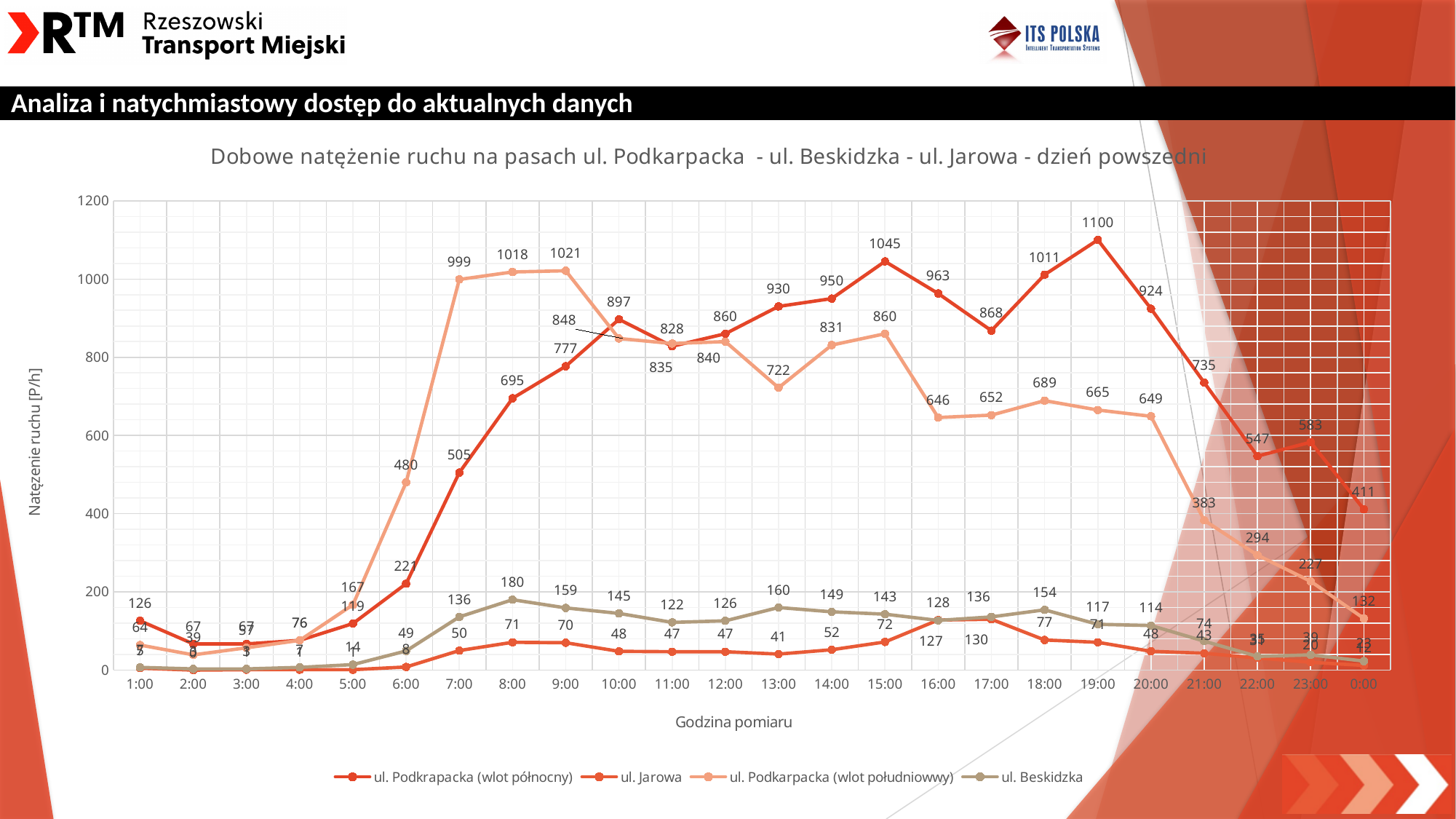
What is the highest value reached by ul. Podkarpacka (wlot południowwy)? 1021 What is the label of the x axis? Godzina pomiaru At which hour does ul. Podkrapacka (wlot północny) reach its highest value? 19:00 What is the value for ul. Beskidzka at 13:00? 160 What type of chart is shown on the slide? line chart What is the value for ul. Podkarpacka (wlot południowwy) at 7:00? 999 Do the values for ul. Podkarpacka (wlot południowwy) rise or fall from 20:00 to 0:00? fall How many series does the legend list? 4 What is the difference between the peak of ul. Podkrapacka (wlot północny) (1100) and the peak of ul. Podkarpacka (wlot południowwy) (1021)? 79 At 9:00, which series has the larger value: ul. Podkrapacka (wlot północny) or ul. Podkarpacka (wlot południowwy)? ul. Podkarpacka (wlot południowwy) How many time points are plotted along the x axis? 24 What is the value for ul. Podkrapacka (wlot północny) at 15:00? 1045